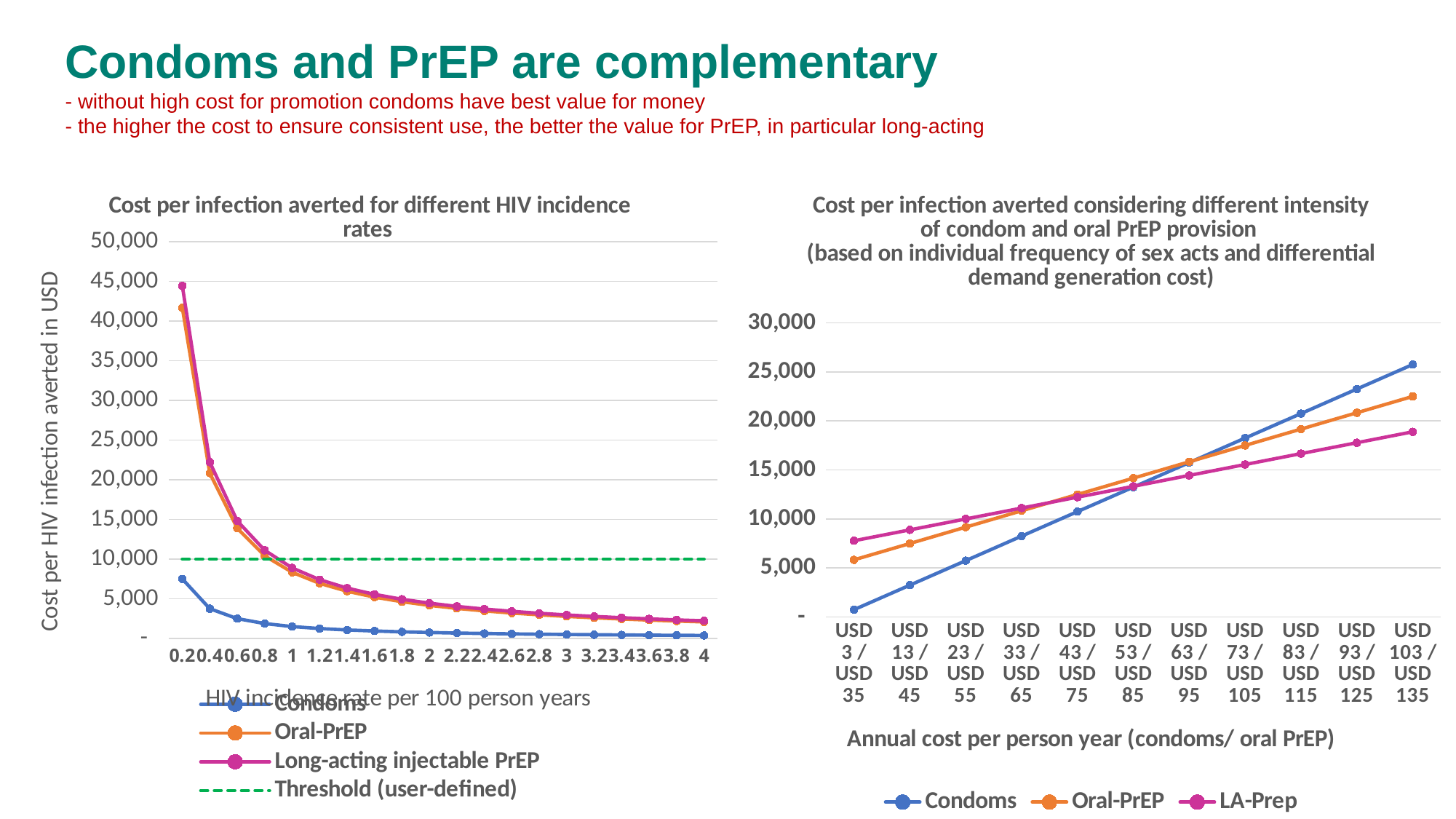
In the right chart, do the values for Condoms rise or fall as the annual cost per person year increases? Rise In the left chart, is the value for Long-acting injectable PrEP at an HIV incidence rate of 0.2 greater or less than 40,000? greater In the right chart, which is larger at 'USD 103 / USD 135': Condoms or LA-Prep? Condoms In the right chart, is the value for Condoms at 'USD 3 / USD 35' greater or less than 5,000? less In the left chart, at what value on the y axis is the dashed 'Threshold (user-defined)' line drawn? 10,000 How many series does the legend of the left chart list? 4 How many series does the legend of the right chart list? 3 In the left chart, is the value for Condoms at an HIV incidence rate of 0.2 greater or less than 10,000? less How many categories are shown on the x axis of the right chart? 11 In the left chart, which is larger at an HIV incidence rate of 0.2: Long-acting injectable PrEP or Condoms? Long-acting injectable PrEP In the left chart, do the values for Oral-PrEP rise or fall as the HIV incidence rate increases? Fall What type of chart is the left chart, 'Cost per infection averted for different HIV incidence rates'? Line chart